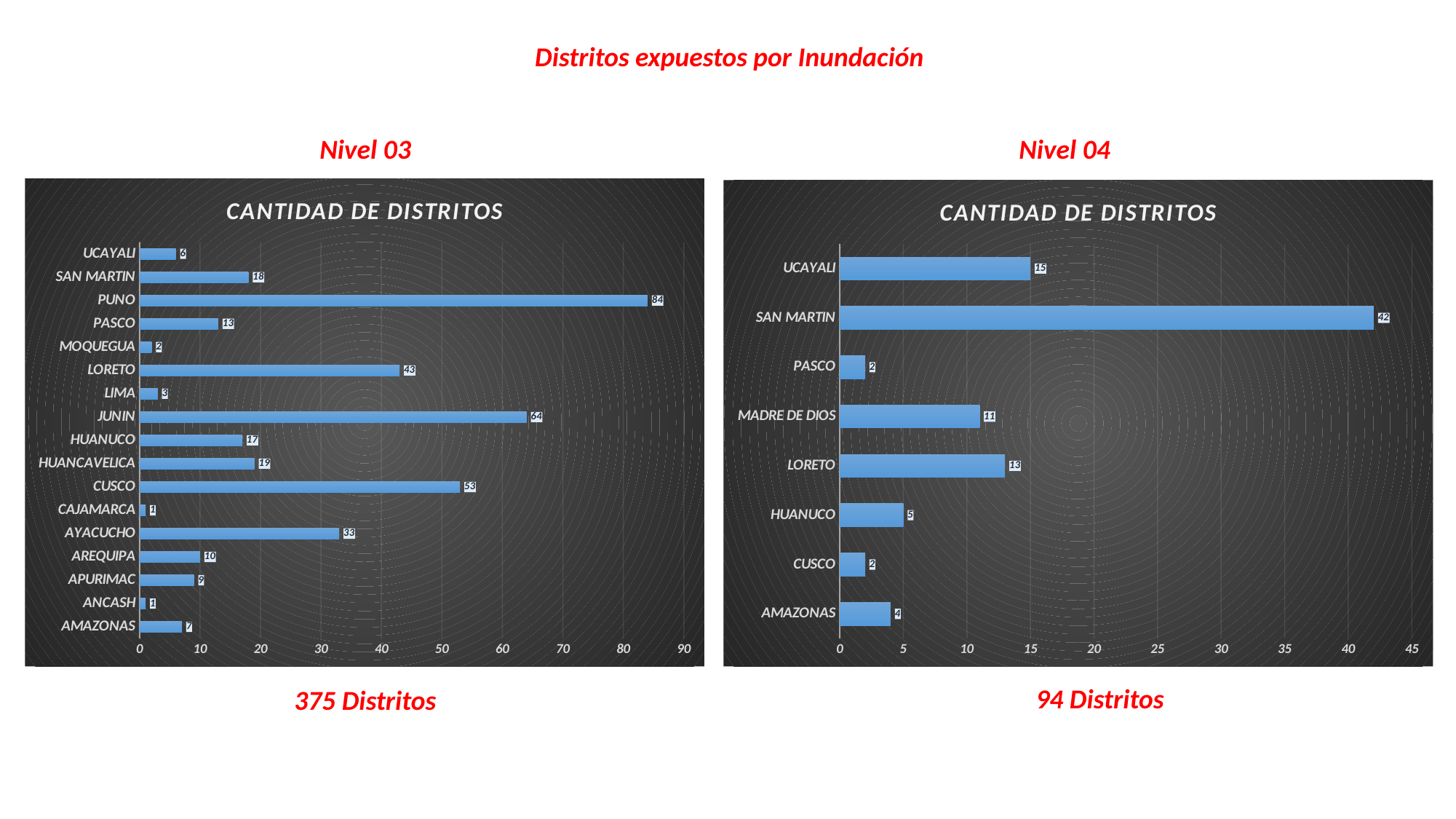
How many categories are shown in the Nivel 04 chart on the right? 8 In the Nivel 03 chart on the left, which category has the highest value? PUNO How many categories are shown in the Nivel 03 chart on the left? 17 In the Nivel 04 chart on the right, what is the difference between the values for UCAYALI and LORETO? 2 In the Nivel 04 chart on the right, which category has the highest value? SAN MARTIN In the Nivel 04 chart on the right, what is the value for MADRE DE DIOS? 11 What kind of chart is the Nivel 04 chart on the right? Bar chart In the Nivel 03 chart on the left, what is the value for PUNO? 84 In the Nivel 03 chart on the left, what is the difference between the values for JUNIN and CUSCO? 11 In the Nivel 04 chart on the right, which category has the lowest value? PASCO and CUSCO (tied at 2) In the Nivel 03 chart on the left, is the value for CUSCO greater or less than 50? greater In the Nivel 03 chart on the left, which is larger, the value for LORETO or the value for AYACUCHO? LORETO